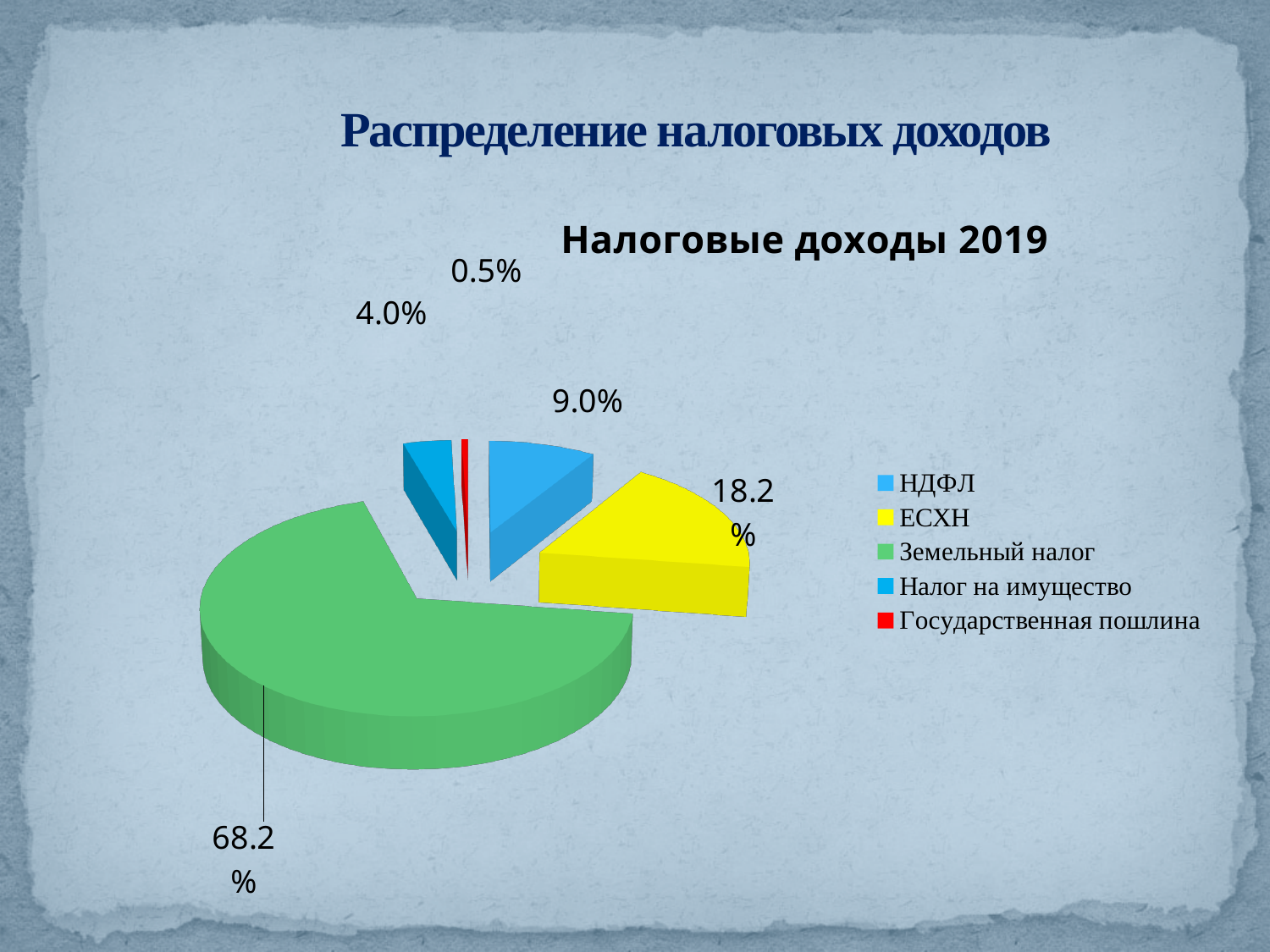
What colour is the slice for Земельный налог? Green How many categories does the chart's legend list? 5 What share of tax revenue does Земельный налог account for? 68.2% What share of tax revenue does Государственная пошлина account for? 0.5% Is the share of Земельный налог greater or less than 50%? greater What is the title of the chart? Налоговые доходы 2019 What kind of chart is shown on the slide? Pie chart Which has a larger share, ЕСХН or Государственная пошлина? ЕСХН Which category has the smallest share of the pie? Государственная пошлина Which category has the largest share of the pie? Земельный налог What share of tax revenue does ЕСХН account for? 18.2% By how many percentage points does the share of Земельный налог exceed the share of ЕСХН? 50.0 percentage points